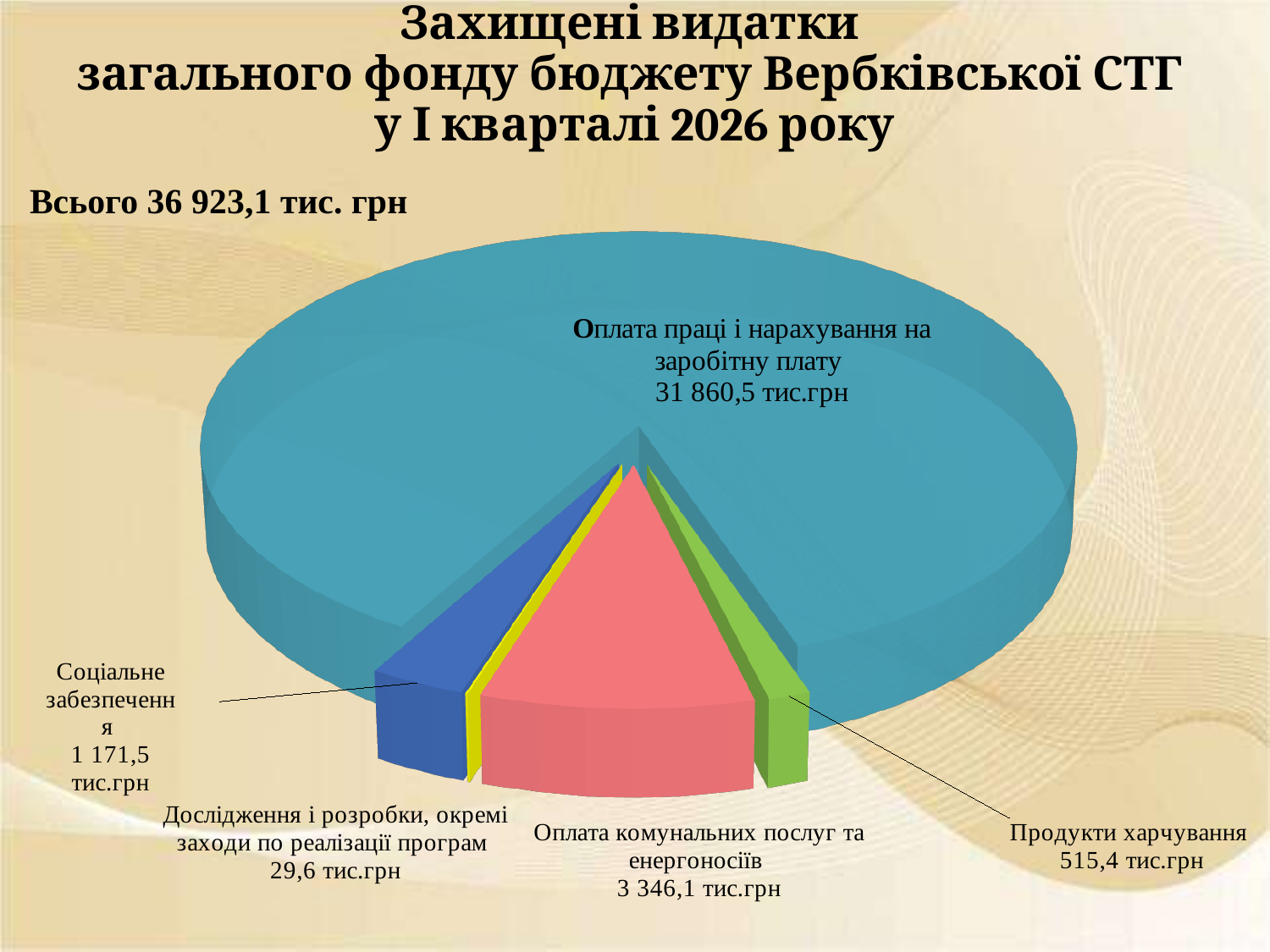
What is the value for "Соціальне забезпечення"? 1 171,5 тис.грн What type of chart is shown on the slide? pie chart What is the value for "Оплата комунальних послуг та енергоносіїв"? 3 346,1 тис.грн What is the difference between "Оплата комунальних послуг та енергоносіїв" and "Соціальне забезпечення"? 2 174,6 тис.грн What is the value for "Дослідження і розробки, окремі заходи по реалізації програм"? 29,6 тис.грн What is the value for "Оплата праці і нарахування на заробітну плату"? 31 860,5 тис.грн Which category has the smallest slice of the pie? Дослідження і розробки, окремі заходи по реалізації програм How many slices does the pie chart have? 5 What total amount is stated on the slide for the protected expenditures? 36 923,1 тис. грн Which category has the largest slice of the pie? Оплата праці і нарахування на заробітну плату Which is larger: "Соціальне забезпечення" or "Продукти харчування"? Соціальне забезпечення What is the value for "Продукти харчування"? 515,4 тис.грн